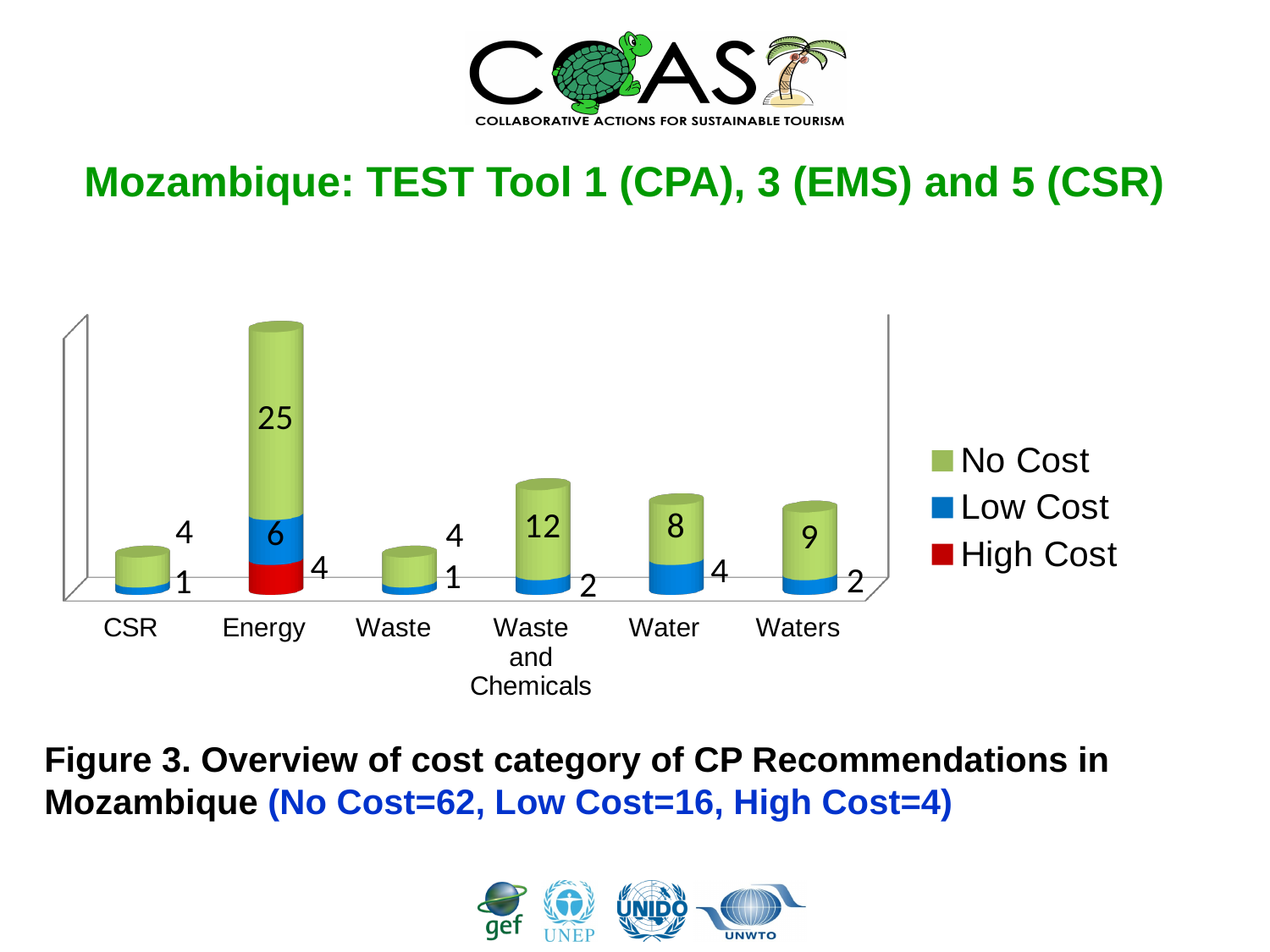
How many series does the legend list? 3 What kind of chart is shown on the slide? Stacked bar chart Which category has the highest No Cost value? Energy Which category has the lowest Low Cost value? CSR and Waste (both 1) What is the No Cost value for Energy? 25 How many categories are shown on the x axis? 6 What is the total of the stacked bar for Energy? 35 What is the No Cost value for Waste and Chemicals? 12 What is the difference between the No Cost values for Energy and Waste and Chemicals? 13 Which is larger, the No Cost value for Water or the No Cost value for Waters? Waters What is the Low Cost value for Water? 4 What is the High Cost value for Energy? 4